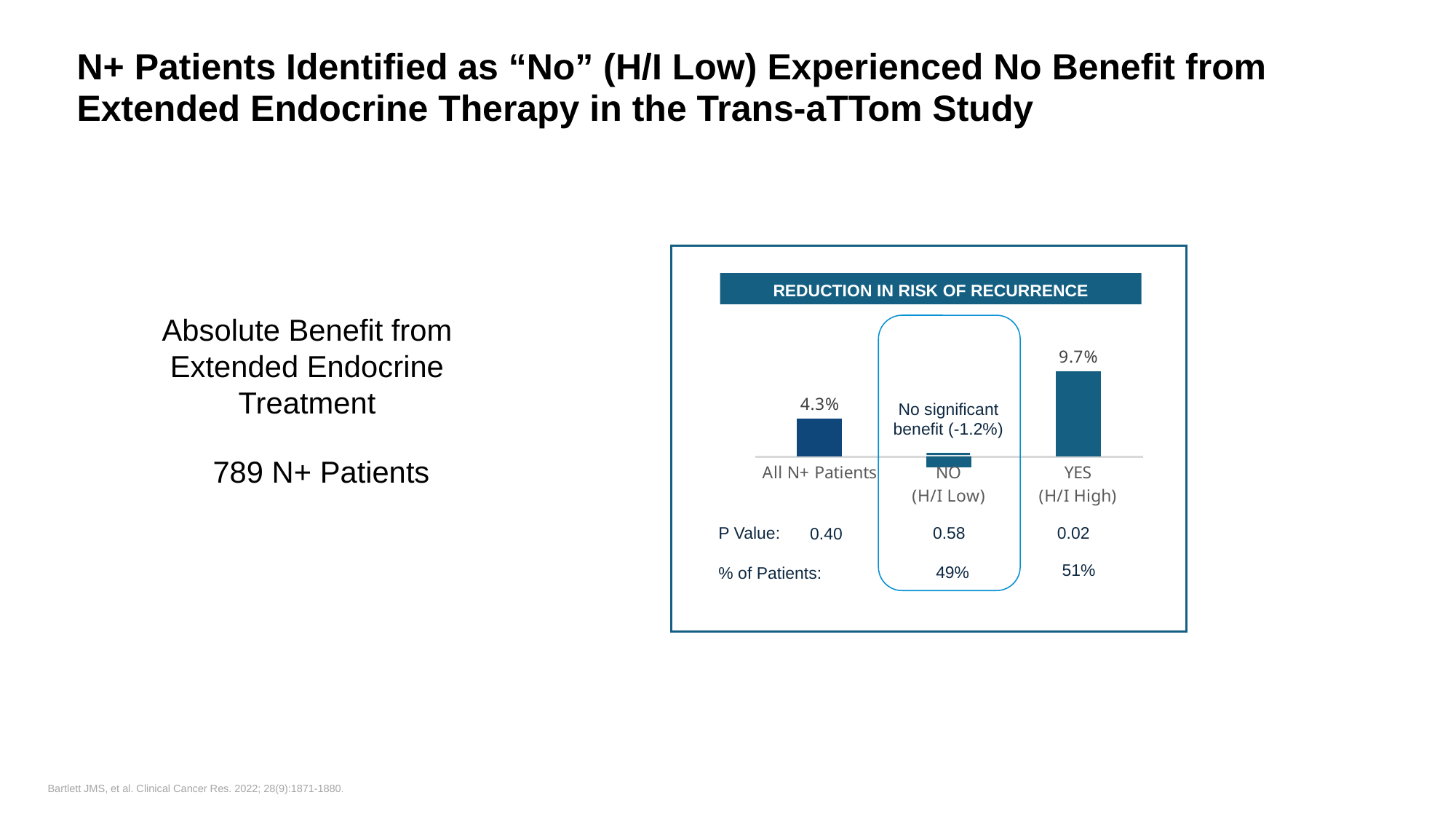
Which category has the lowest reduction in risk of recurrence? NO (H/I Low) What is the difference in reduction in risk of recurrence between the YES (H/I High) group and All N+ Patients? 5.4% How many categories are shown in the chart? 3 What is the P value for the YES (H/I High) group? 0.02 What is the reduction in risk of recurrence for the YES (H/I High) group? 9.7% What kind of chart is shown on the slide? Bar chart Which has a larger reduction in risk of recurrence, All N+ Patients or the YES (H/I High) group? YES (H/I High) What is the reduction in risk of recurrence for All N+ Patients? 4.3% What percentage of patients are in the NO (H/I Low) group? 49% Which category has the highest reduction in risk of recurrence? YES (H/I High) What is the reduction in risk of recurrence for the NO (H/I Low) group? -1.2% What is the title of the chart? REDUCTION IN RISK OF RECURRENCE